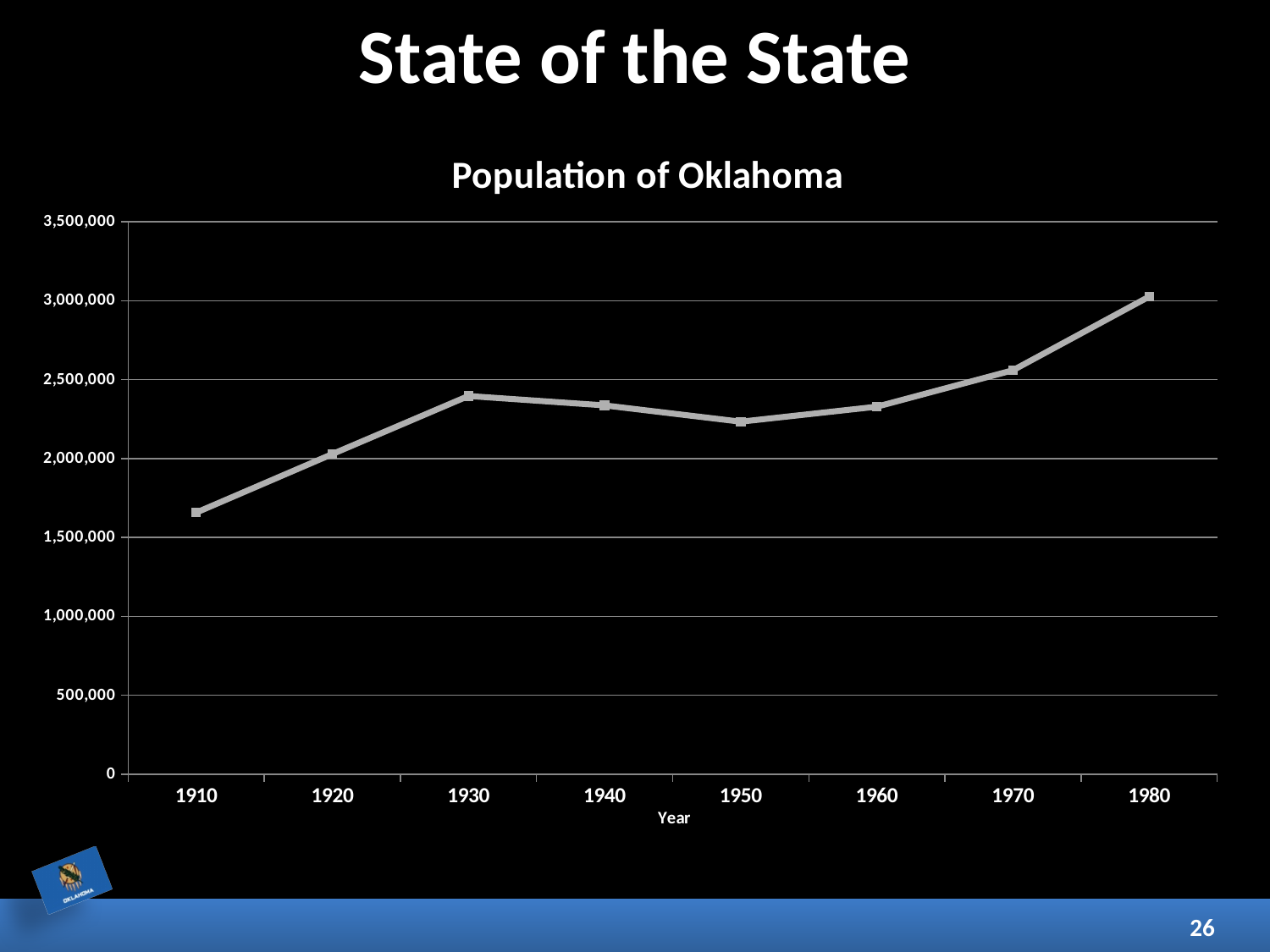
Is the population value for 1910 greater or less than 2,000,000? less Is the population value for 1950 greater or less than 2,000,000? greater Which year has the lowest population on the chart? 1910 What is the label on the x axis of the chart? Year Which year has the highest population on the chart? 1980 What is the title of the chart? Population of Oklahoma How many data points are plotted on the line? 8 Does the population rise or fall between 1930 and 1950? fall Is the population value for 1960 greater or less than 2,500,000? less Which year has the larger population, 1930 or 1950? 1930 What kind of chart is shown on the slide? line chart